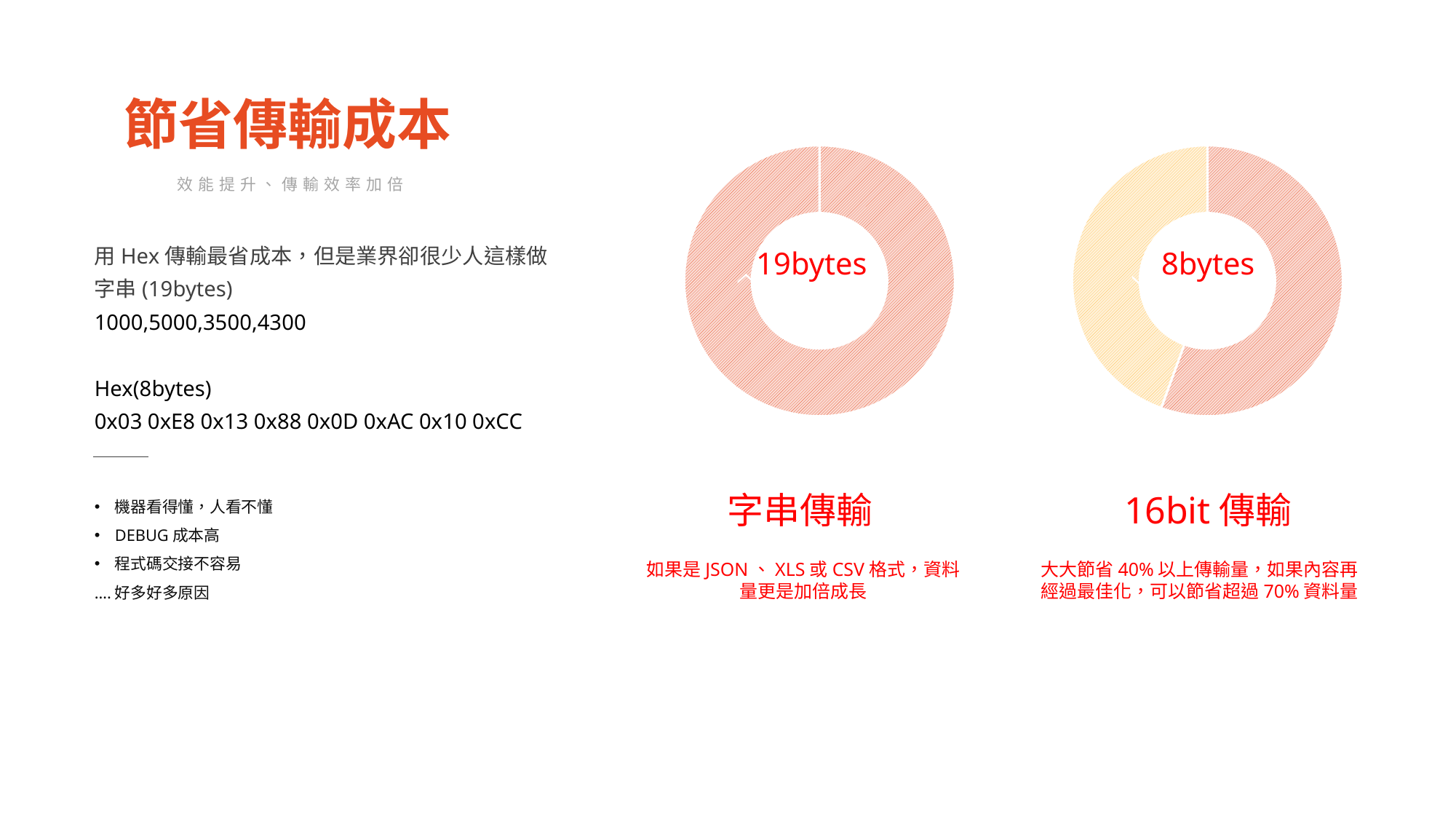
What is the difference in bytes between the centre values of the 字串傳輸 chart and the 16bit 傳輸 chart? 11 bytes In the 16bit 傳輸 donut chart, which slice is larger, the yellow one or the red one? The red one How many slices does the 16bit 傳輸 donut chart have? 2 Which chart shows the larger byte count in its centre, 字串傳輸 or 16bit 傳輸? 字串傳輸 What is the title printed below the left donut chart? 字串傳輸 How many donut charts are on the slide? 2 What is the title printed below the right donut chart? 16bit 傳輸 What value is printed in the centre of the 16bit 傳輸 donut chart? 8bytes What value is printed in the centre of the 字串傳輸 donut chart? 19bytes What kind of chart is shown on the right side of the slide under 字串傳輸? Donut (pie) chart